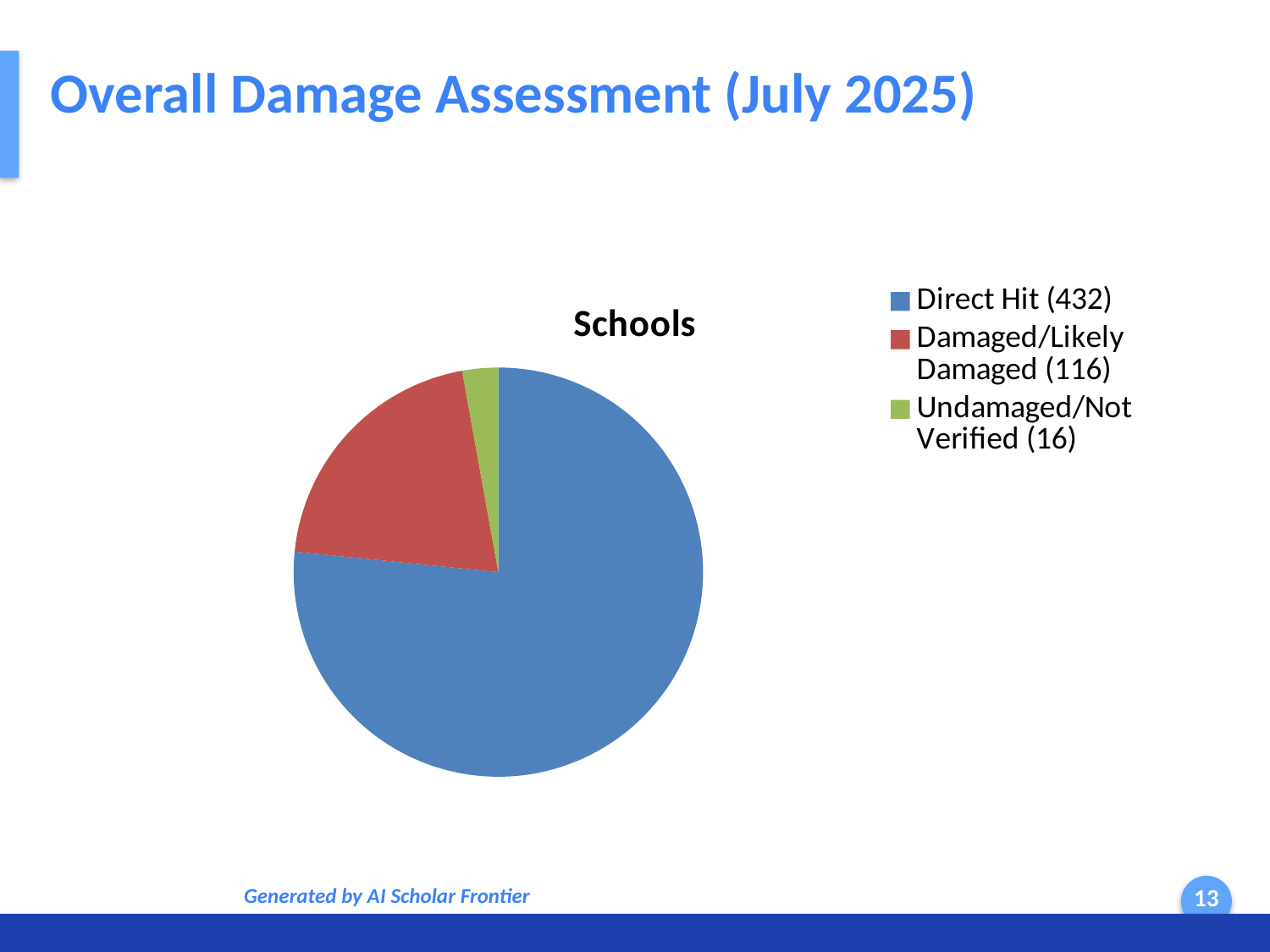
Which is larger, Damaged/Likely Damaged or Undamaged/Not Verified? Damaged/Likely Damaged What is the value for Undamaged/Not Verified? 16 What is the title of the pie chart? Schools What is the value for Damaged/Likely Damaged? 116 How many entries does the legend list? 3 What is the total of all three categories in the pie chart? 564 What kind of chart is shown on the slide? pie chart How many slices does the pie chart have? 3 What is the difference between the Direct Hit value and the Damaged/Likely Damaged value? 316 What is the value for Direct Hit? 432 Which category has the smallest slice? Undamaged/Not Verified Which category has the largest slice? Direct Hit